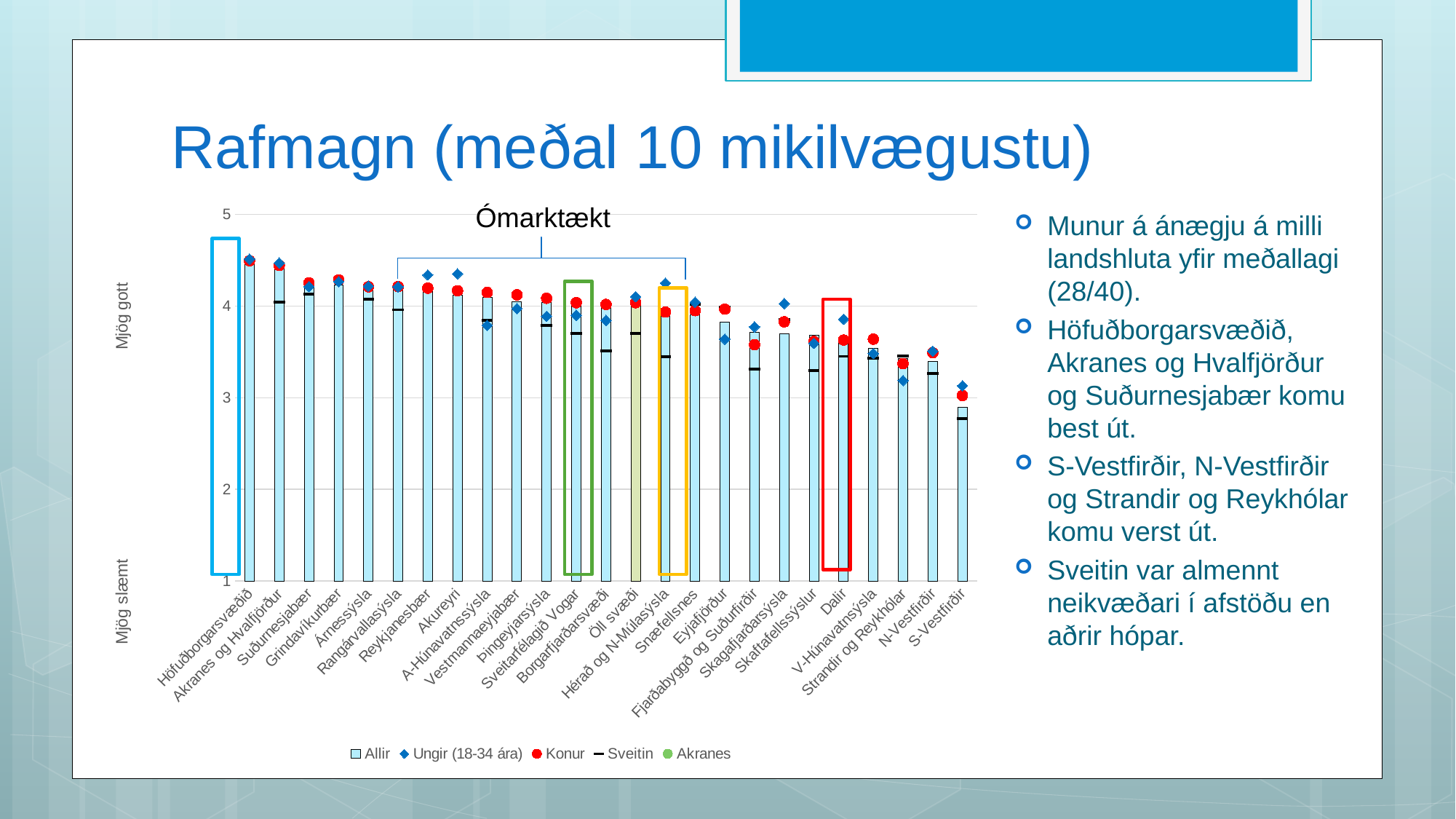
How many categories are shown along the x axis of the chart? 25 Is the Allir value for Dalir greater or less than 4? less Is the Allir value for Höfuðborgarsvæðið greater or less than 4? greater What kind of chart is shown on the slide? bar chart Which category has the highest Allir bar? Höfuðborgarsvæðið What label appears at the top of the y axis of the chart? Mjög gott Do the Allir bar values generally rise or fall from left to right along the x axis? fall Is the Allir value for Strandir og Reykhólar greater or less than 3? greater Which series in the legend is shown with a blue diamond marker? Ungir (18-34 ára) How many series does the chart legend list? 5 Which has the larger Allir value, Akranes og Hvalfjörður or Eyjafjörður? Akranes og Hvalfjörður Which category has the lowest Allir bar? S-Vestfirðir